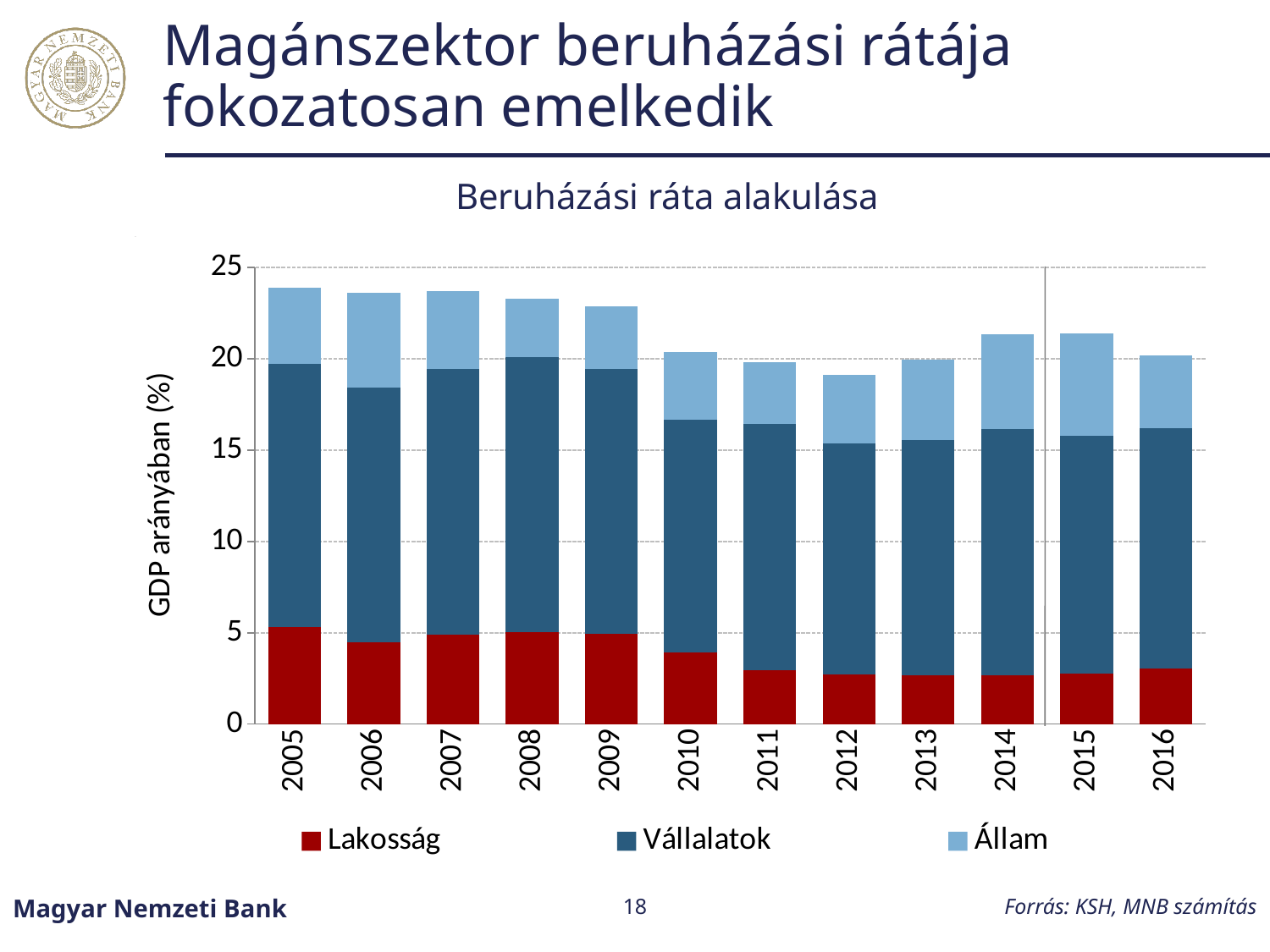
How many years are shown on the x axis? 12 Which year has the highest total investment rate? 2005 Is the total bar for 2014 greater or less than 20? greater Does the total investment rate rise or fall from 2005 to 2012? fall Is the total bar for 2012 greater or less than 20? less What kind of chart is shown on the slide? Stacked bar chart What is the label of the y axis? GDP arányában (%) How many series does the legend list? 3 Which year has the lowest total investment rate? 2012 Is the Lakosság value for 2011 greater or less than 5? less Which year has the larger total bar, 2013 or 2014? 2014